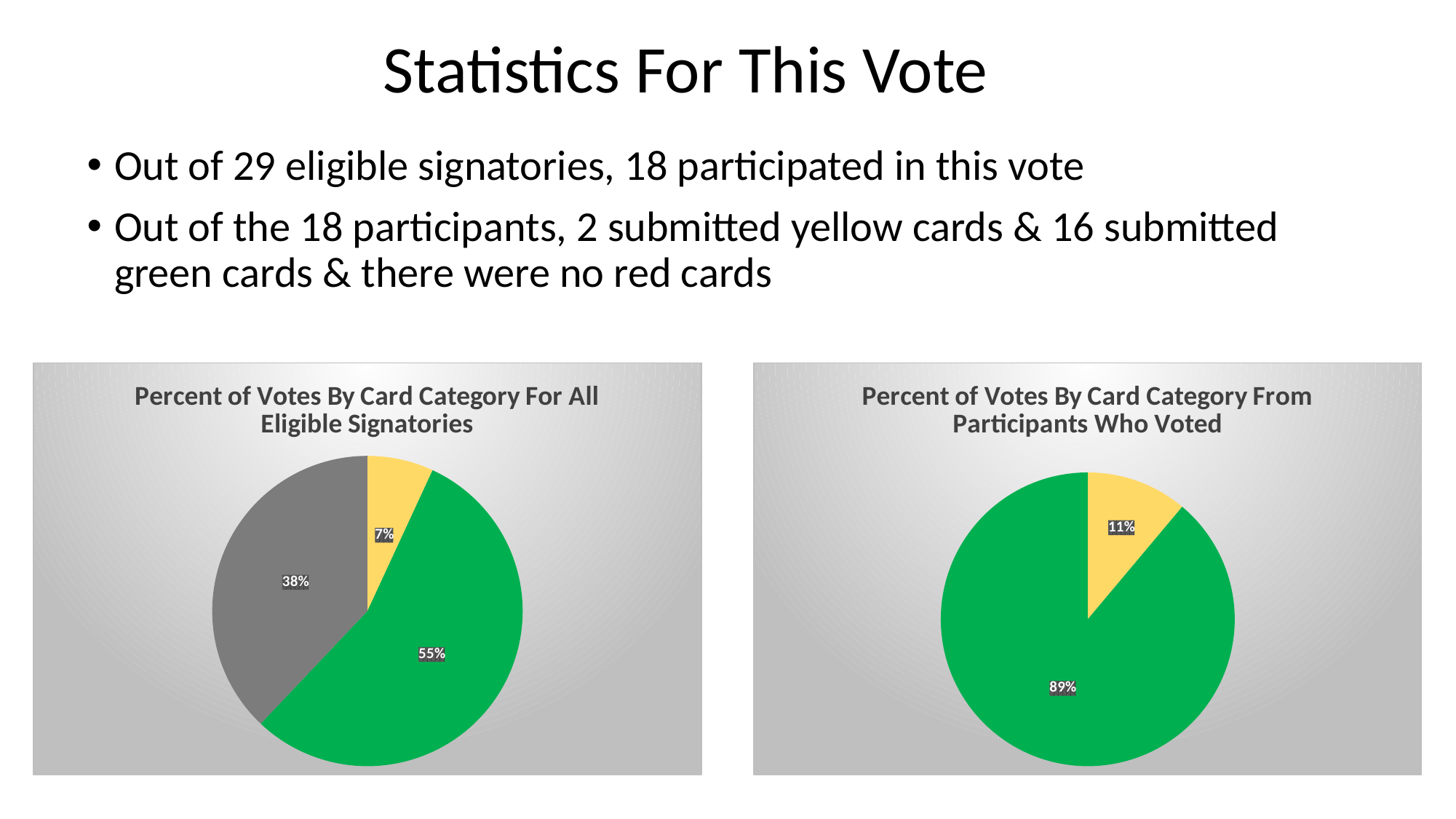
In the right chart, what is the difference in percentage points between the green slice and the yellow slice? 78 In the left chart, what is the difference in percentage points between the green slice and the grey slice? 17 In the chart titled "Percent of Votes By Card Category For All Eligible Signatories", what percentage is shown on the grey slice? 38% What type of chart is used on the right side of the slide? Pie chart In the left chart, which colour slice is the smallest? Yellow In the chart titled "Percent of Votes By Card Category For All Eligible Signatories", what percentage is shown on the yellow slice? 7% In the left chart, which colour slice is the largest? Green In the chart titled "Percent of Votes By Card Category From Participants Who Voted", what percentage is shown on the green slice? 89% How many slices does the left pie chart have? 3 How many slices does the right pie chart have? 2 In the chart titled "Percent of Votes By Card Category For All Eligible Signatories", what percentage is shown on the green slice? 55% In the chart titled "Percent of Votes By Card Category From Participants Who Voted", what percentage is shown on the yellow slice? 11%